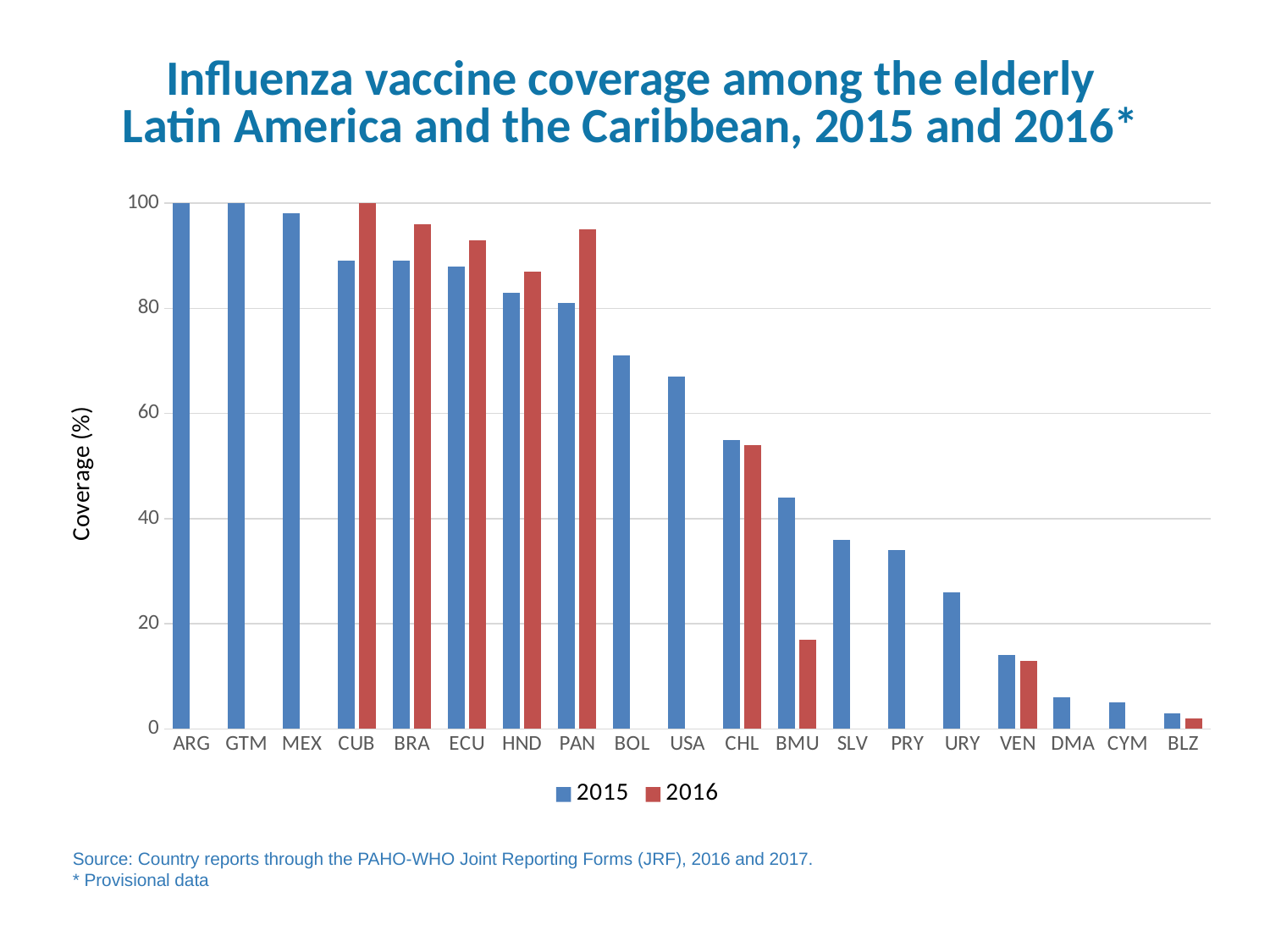
How many series does the legend list? 2 Is the 2015 coverage value for BOL greater or less than 60? greater For BMU, which year has the larger coverage value, 2015 or 2016? 2015 Which country has the highest 2016 coverage value? CUB Which country has the lowest 2015 coverage value? BLZ What is the 2015 influenza vaccine coverage value for ARG? 100 What is the 2016 coverage value for CUB? 100 How many countries are shown on the x axis? 19 What kind of chart is shown on the slide? Bar chart For PAN, which year has the larger coverage value, 2015 or 2016? 2016 Which country has the lowest 2016 coverage value? BLZ Is the 2015 coverage value for SLV greater or less than 40? less